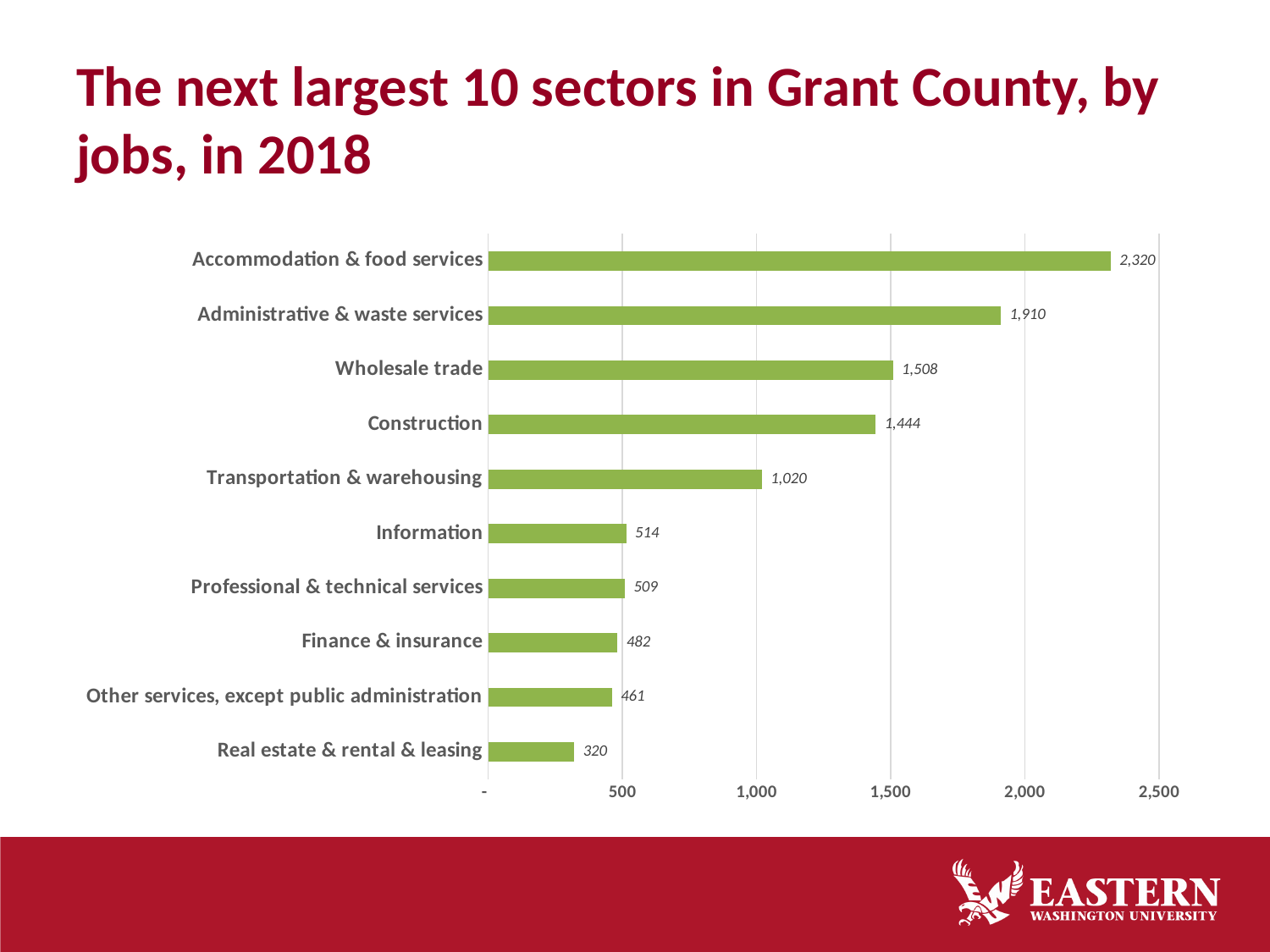
Is the value for Construction greater or less than 1,500? less Which sector has the highest number of jobs on the chart? Accommodation & food services Which sector has the lowest number of jobs on the chart? Real estate & rental & leasing What is the difference in jobs between Accommodation & food services and Administrative & waste services? 410 What is the value shown for Real estate & rental & leasing? 320 What is the difference in jobs between Construction and Transportation & warehousing? 424 What is the value shown for Transportation & warehousing? 1,020 What is the title of the slide? The next largest 10 sectors in Grant County, by jobs, in 2018 How many sectors are shown on the chart? 10 Which has more jobs, Finance & insurance or Other services, except public administration? Finance & insurance How many jobs does the Wholesale trade sector have? 1,508 What kind of chart is shown on the slide? Bar chart